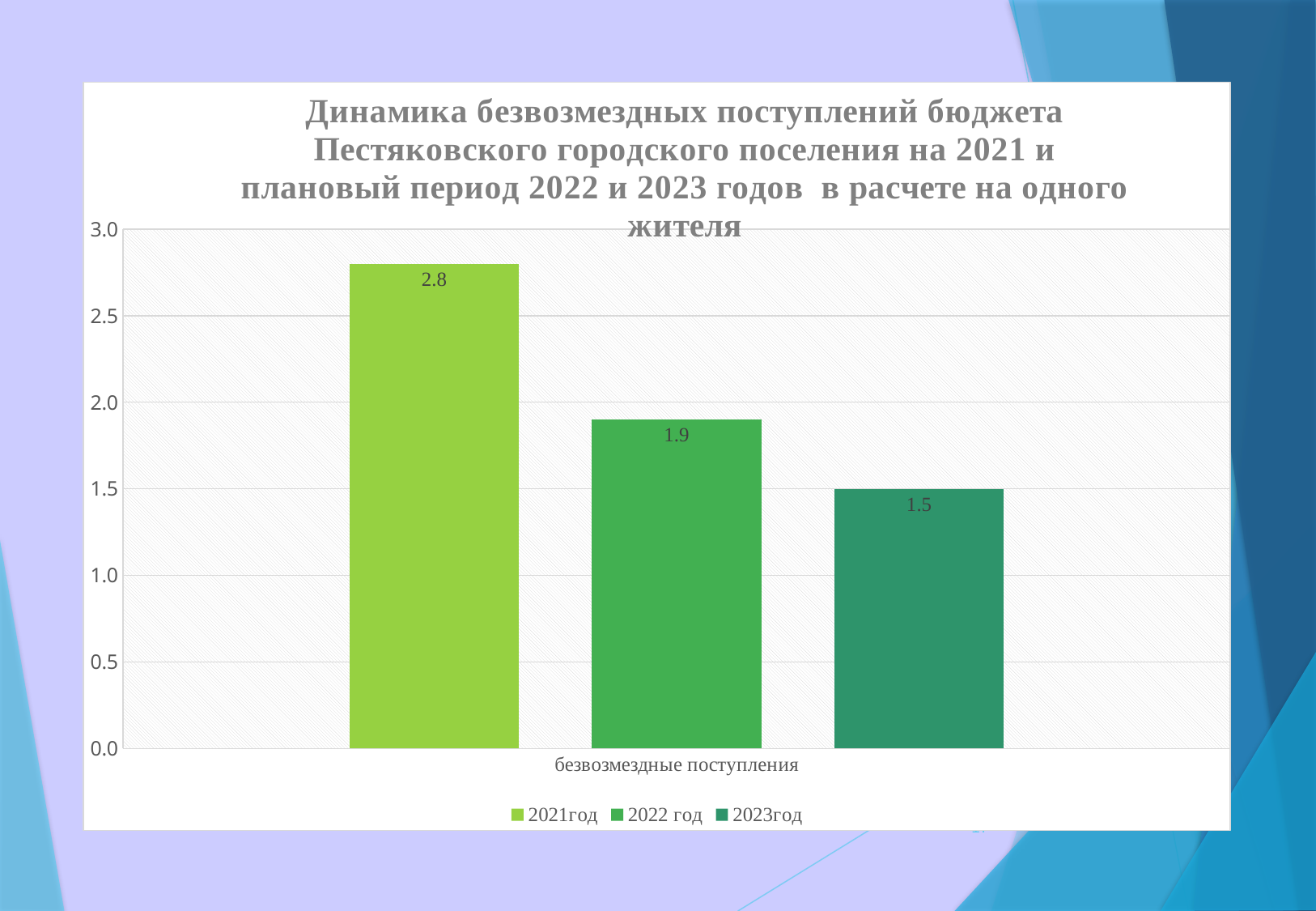
What is the value for 2023год (2023 year) in the chart? 1.5 Which year has the highest value in the chart? 2021год What is the value for 2022 год (2022 year) in the chart? 1.9 Do the values rise or fall from 2021год to 2023год? fall Which is larger, the value for 2022 год or the value for 2023год? 2022 год What is the value for 2021год (2021 year) in the chart? 2.8 What is the difference between the values for 2021год and 2023год? 1.3 What kind of chart is shown on the slide? bar chart Is the value for 2021год greater or less than 2.5? greater Which year has the lowest value in the chart? 2023год What is the difference between the values for 2021год and 2022 год? 0.9 How many series does the legend list? 3